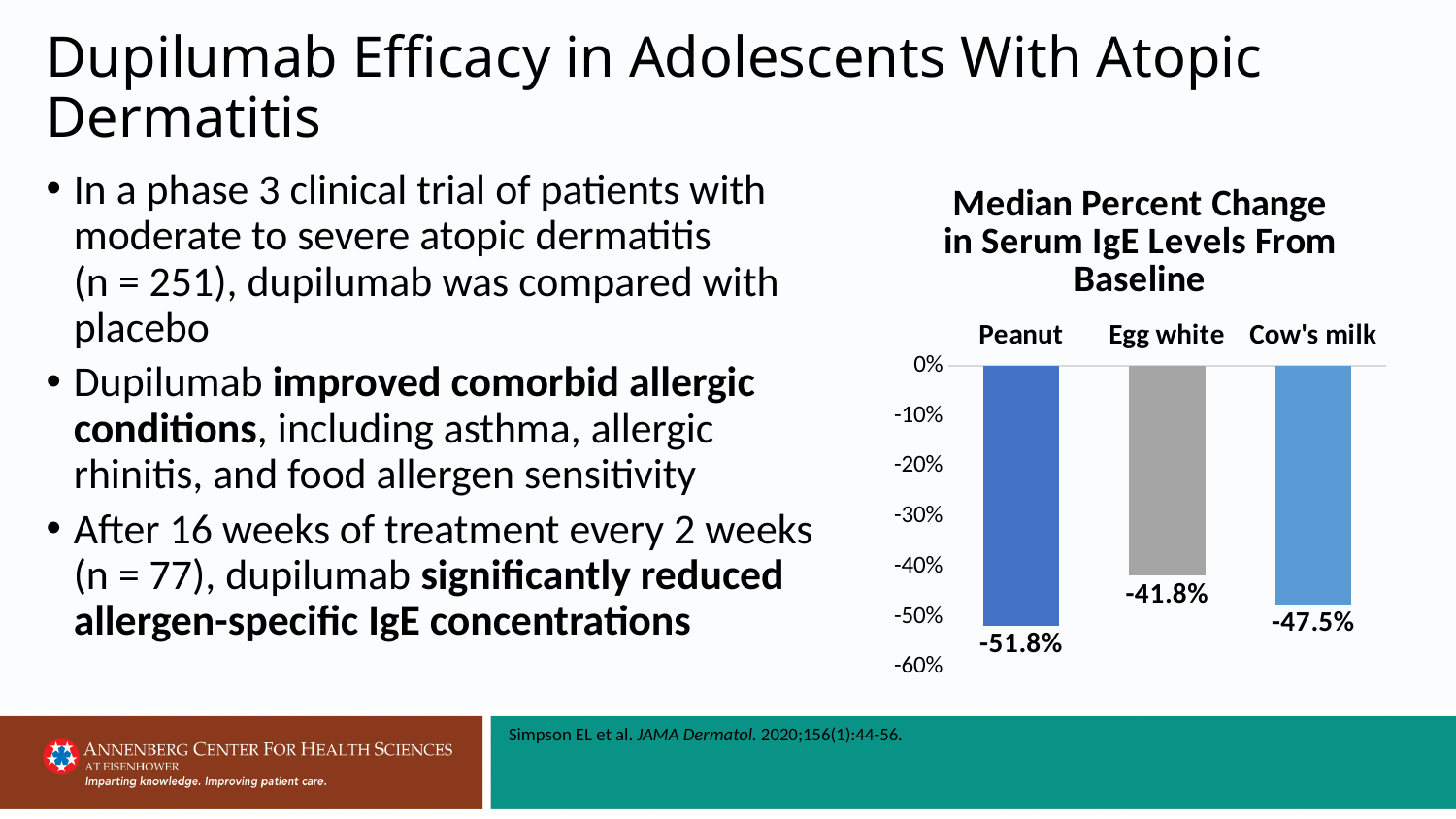
What is the median percent change in serum IgE for Peanut? -51.8% What type of chart is used to show the median percent change in serum IgE levels? Bar chart Which allergen shows the largest reduction (most negative value) in serum IgE? Peanut Which has a larger reduction in serum IgE, Cow's milk or Egg white? Cow's milk How many allergen categories are shown in the chart? 3 What is the difference in percentage points between the Peanut and Cow's milk values? 4.3 percentage points Which allergen shows the smallest reduction (least negative value) in serum IgE? Egg white Is the value for Egg white greater or less than -50%? greater What is the median percent change in serum IgE for Egg white? -41.8% What is the title of the chart? Median Percent Change in Serum IgE Levels From Baseline What is the median percent change in serum IgE for Cow's milk? -47.5% What is the difference in percentage points between the Peanut and Egg white values? 10 percentage points